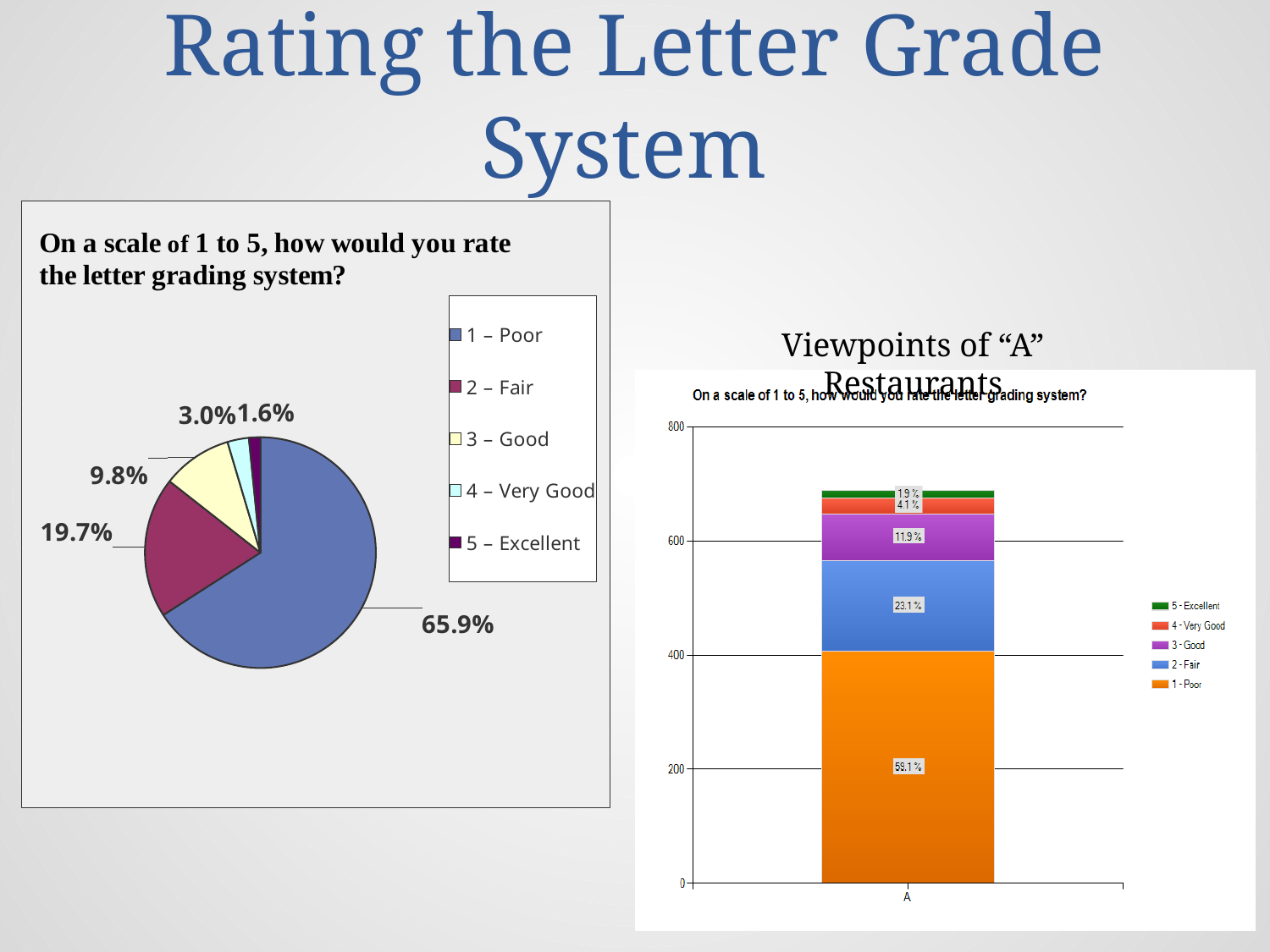
In the pie chart on the left, which rating has the smallest slice? 5 – Excellent In the 'Viewpoints of "A" Restaurants' chart, which rating has the largest segment? 1 - Poor In the pie chart on the left, what share of respondents rated the letter grading system 2 – Fair? 19.7% In the 'Viewpoints of "A" Restaurants' chart, is the total height of the stacked bar greater or less than 600? greater In the pie chart on the left, what share of respondents rated the letter grading system 1 – Poor? 65.9% In the 'Viewpoints of "A" Restaurants' chart, what percentage is labelled on the 3 - Good segment? 11.9% In the pie chart on the left, what share of respondents rated the letter grading system 5 – Excellent? 1.6% What kind of chart is the 'Viewpoints of "A" Restaurants' chart? Stacked bar chart In the pie chart on the left, what is the difference between the 1 – Poor share and the 2 – Fair share? 46.2% In the 'Viewpoints of "A" Restaurants' chart, what percentage is labelled on the 1 - Poor segment? 59.1% What kind of chart is the chart on the left? Pie chart How many entries does the legend of the pie chart on the left list? 5